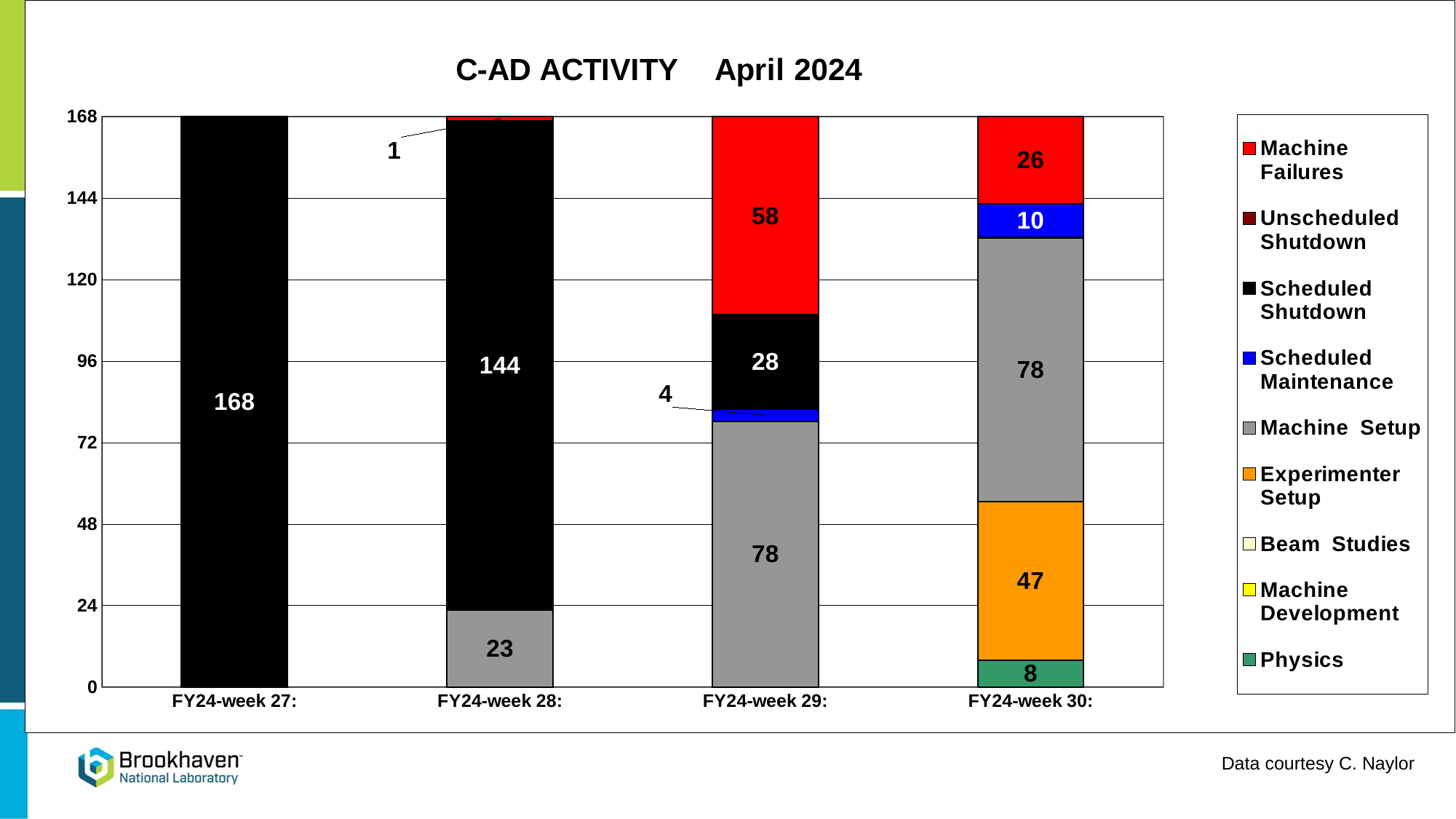
What is the difference between the Machine Failures values for FY24-week 29 and FY24-week 30? 32 What is the value for Scheduled Maintenance in FY24-week 30? 10 What kind of chart is shown on the slide? Stacked bar chart What is the value for Experimenter Setup in FY24-week 30? 47 Which week has the larger Scheduled Shutdown value, FY24-week 28 or FY24-week 29? FY24-week 28: How many series does the legend list? 9 What is the value for Machine Setup in FY24-week 28? 23 What is the value for Scheduled Shutdown in FY24-week 27? 168 What is the total of the stacked bar for FY24-week 29? 168 What is the value for Machine Failures in FY24-week 29? 58 How many weeks are shown on the x axis? 4 Which week has the highest value for Machine Failures? FY24-week 29: